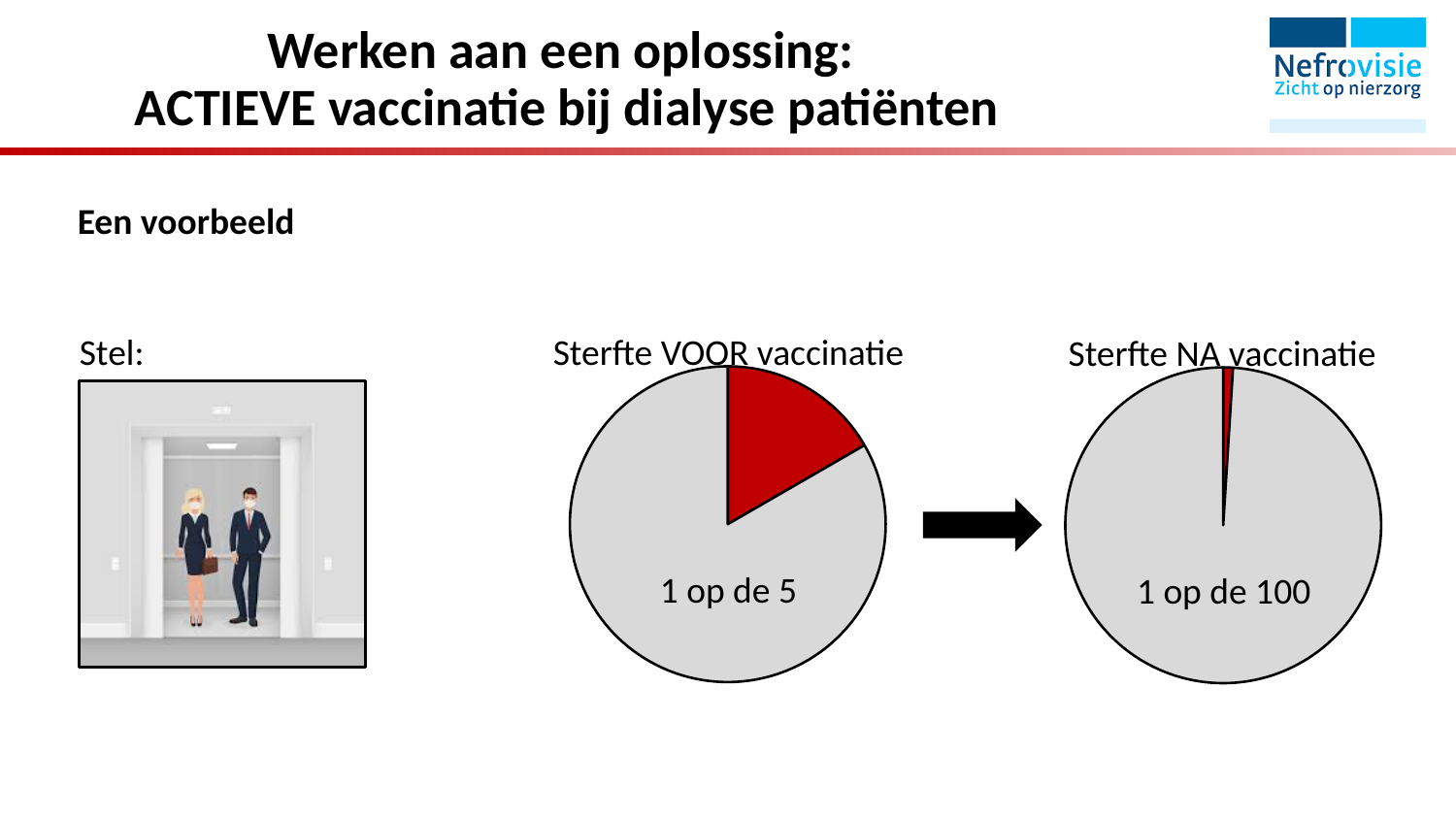
How many pie charts are shown on the slide? 2 In the 'Sterfte VOOR vaccinatie' chart, what value is printed inside the pie? 1 op de 5 What kind of chart is the 'Sterfte VOOR vaccinatie' chart? pie chart How many slices does the 'Sterfte VOOR vaccinatie' pie chart have? 2 How many slices does the 'Sterfte NA vaccinatie' pie chart have? 2 What kind of chart is the 'Sterfte NA vaccinatie' chart? pie chart In the 'Sterfte NA vaccinatie' chart, what value is printed inside the pie? 1 op de 100 What colour is the smaller slice in the 'Sterfte NA vaccinatie' pie chart? red In the 'Sterfte VOOR vaccinatie' chart, what share of the pie does the red slice represent according to the printed label? 1 op de 5 What is the title of the pie chart on the left? Sterfte VOOR vaccinatie In the 'Sterfte NA vaccinatie' chart, what share of the pie does the red slice represent according to the printed label? 1 op de 100 Which chart has the larger red slice, 'Sterfte VOOR vaccinatie' or 'Sterfte NA vaccinatie'? Sterfte VOOR vaccinatie